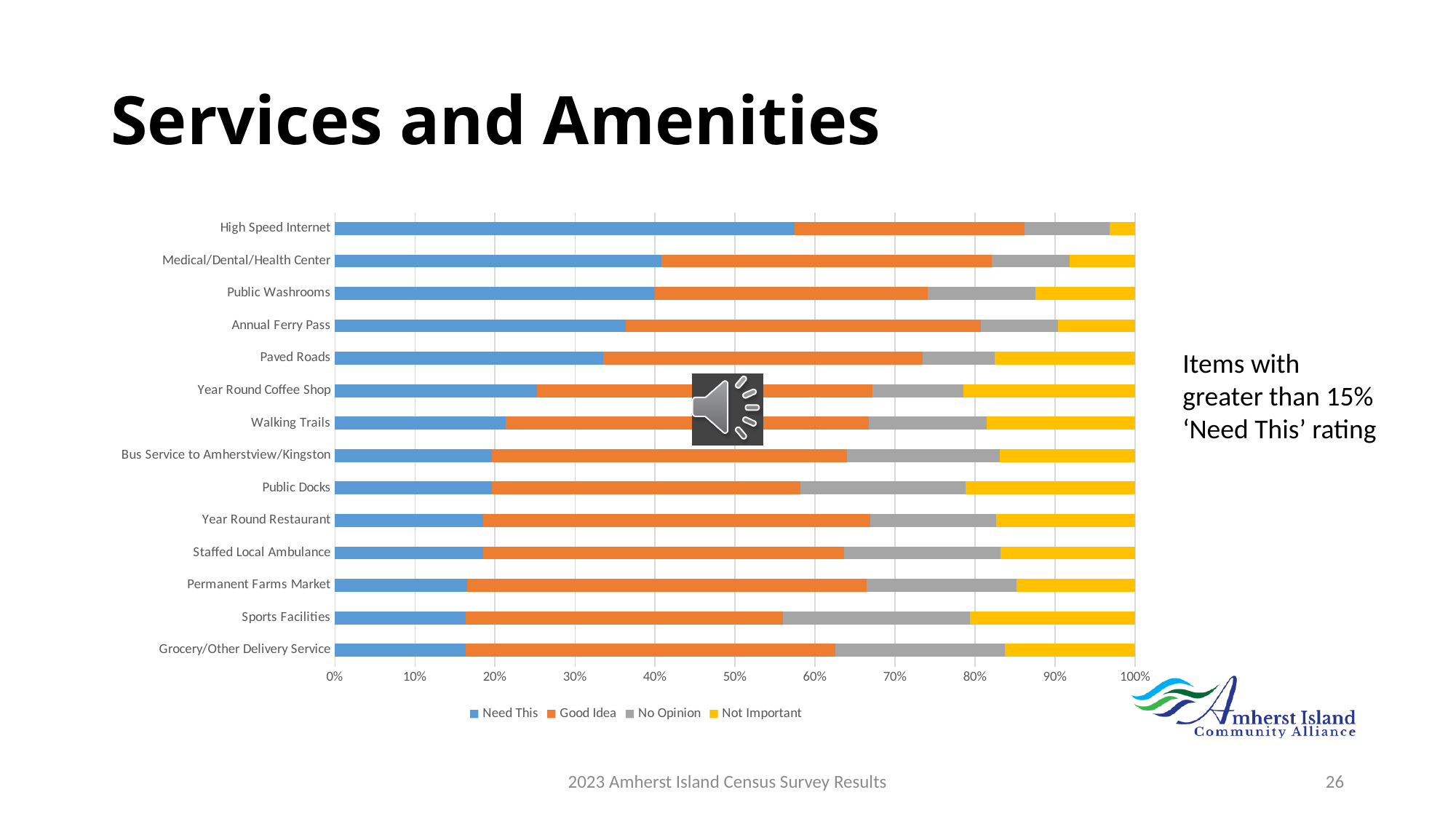
Which item has the highest 'Need This' share? High Speed Internet Which has a larger 'Need This' share, High Speed Internet or Medical/Dental/Health Center? High Speed Internet Is the 'Need This' value for Grocery/Other Delivery Service greater or less than 20%? less Which has a larger 'Not Important' share, Paved Roads or High Speed Internet? Paved Roads What is the first entry in the chart legend? Need This Which series is shown in yellow in the chart legend? Not Important Is the 'Need This' value for Annual Ferry Pass greater or less than 30%? greater What kind of chart is shown on the slide? Stacked bar chart Is the 'Need This' value for High Speed Internet greater or less than 50%? greater How many series does the chart legend list? 4 How many services or amenities are listed on the chart? 14